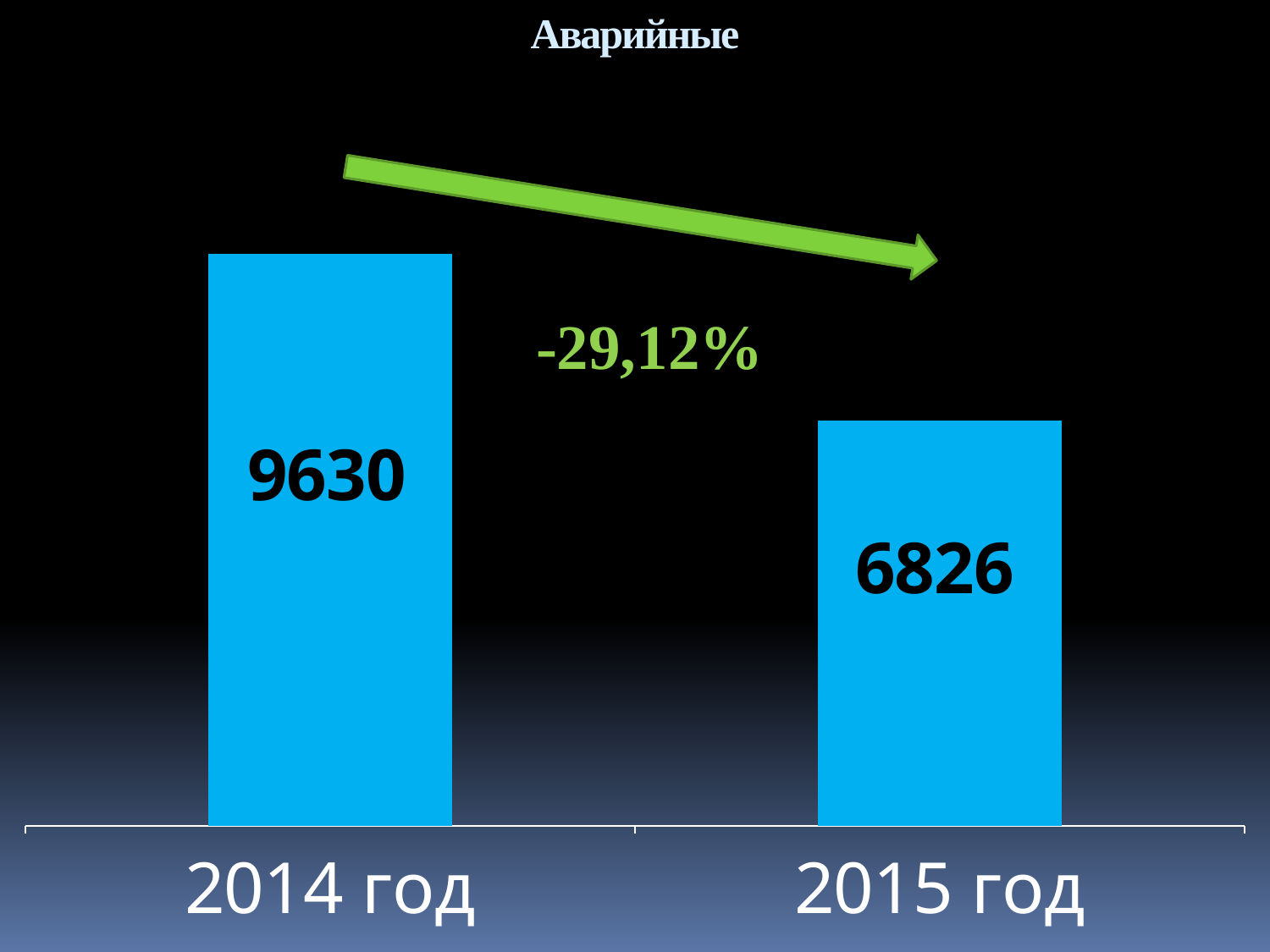
How many categories are shown in the chart? 2 Which is larger, the value for 2014 год or the value for 2015 год? 2014 год What is the title of the chart? Аварийные Do the values rise or fall from 2014 год to 2015 год? fall Which year has the lowest value? 2015 год Which year has the highest value? 2014 год What is the value for 2014 год? 9630 What is the value for 2015 год? 6826 What kind of chart is shown on the slide? bar chart What percentage change is printed between the two bars? -29,12% What is the difference between the values for 2014 год and 2015 год? 2804